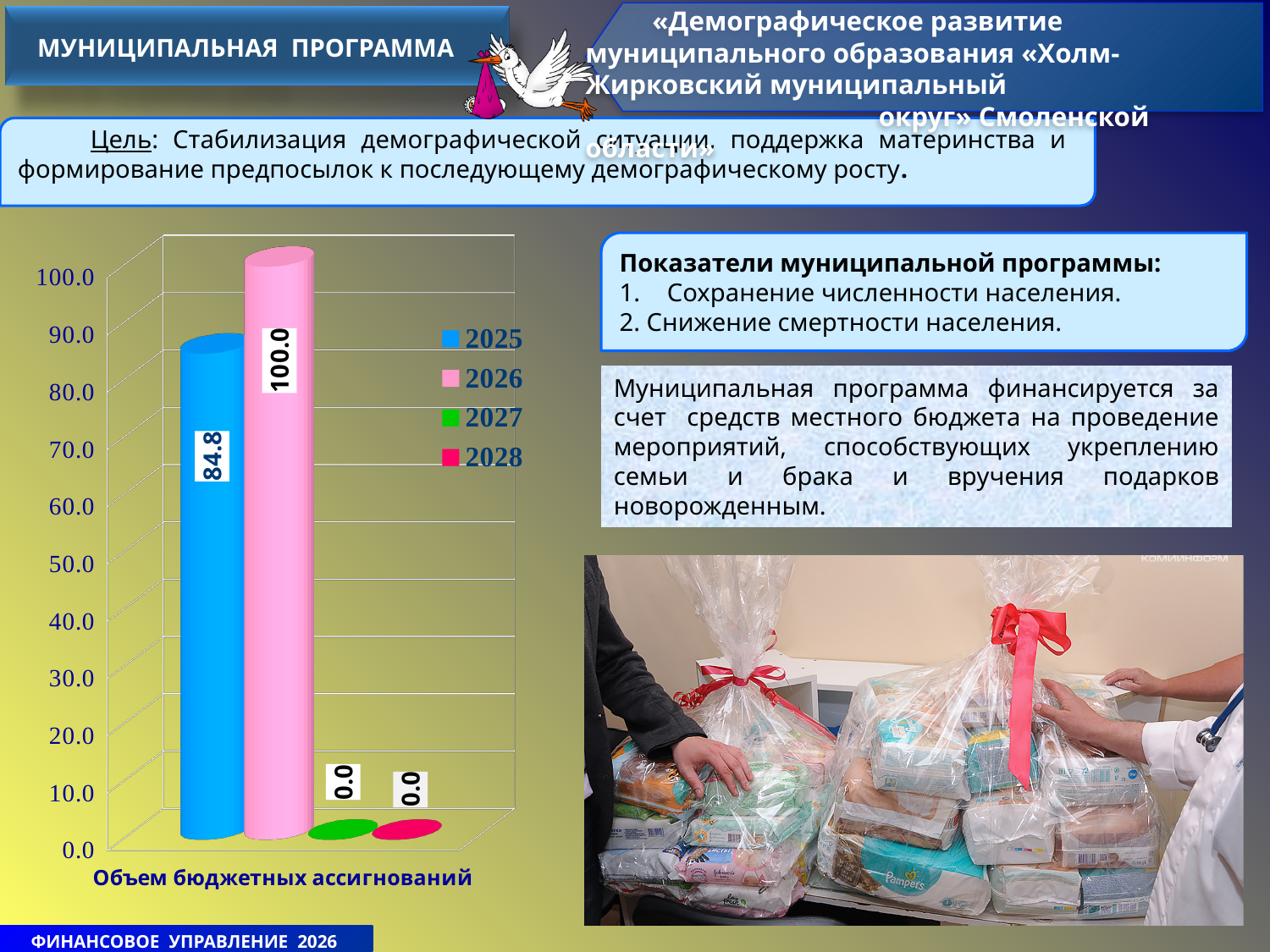
How many series does the chart legend list? 4 What kind of chart is shown on the slide? bar chart What is the difference between the values for 2026 and 2025? 15.2 Which year has the highest value in the chart? 2026 What is the value for 2028 in the chart? 0.0 Which is larger, the value for 2025 or the value for 2026? 2026 What colour is the bar for 2026 in the chart? pink What is the value for 2026 in the chart? 100.0 What is the value for 2027 in the chart? 0.0 What is the value for 2025 in the chart? 84.8 Is the value for 2025 greater or less than 80.0? greater What is the category label shown below the chart? Объем бюджетных ассигнований